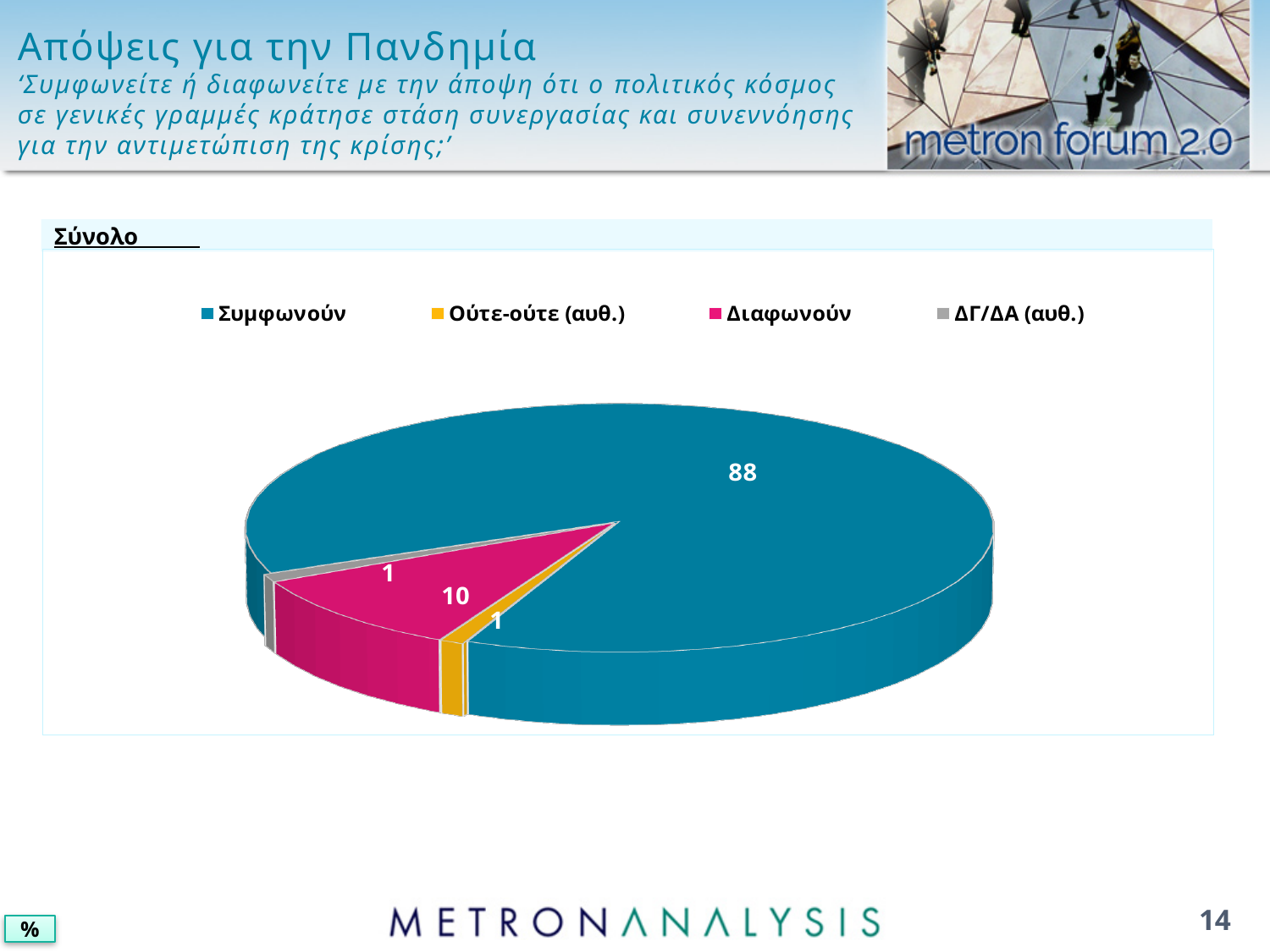
What is the value for Διαφωνούν? 10 What is the value for ΔΓ/ΔΑ (αυθ.)? 1 What is the difference between the values for Συμφωνούν and Διαφωνούν? 78 What is the heading printed above the chart? Σύνολο What kind of chart is shown on the slide? pie chart What colour is the slice for Διαφωνούν? magenta What is the value for Συμφωνούν? 88 What is the value for Ούτε-ούτε (αυθ.)? 1 Which is larger, the value for Διαφωνούν or the value for Ούτε-ούτε (αυθ.)? Διαφωνούν Which category has the largest slice of the pie? Συμφωνούν How many slices does the pie chart have? 4 How many categories does the legend list? 4